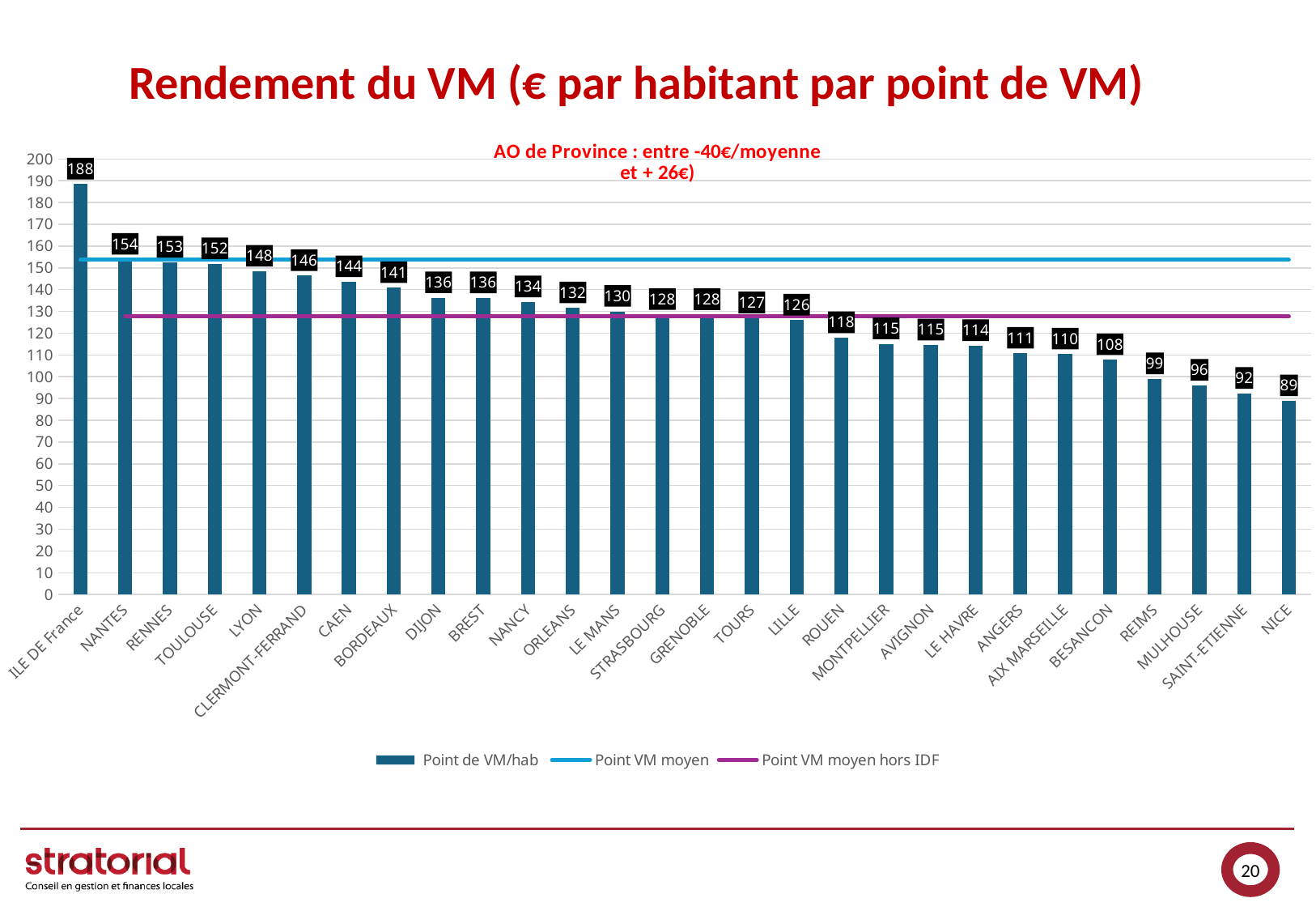
What is the value for NANTES? 154 What is the difference between the values for LYON and ROUEN? 30 What kind of chart is this? combination bar and line chart How many series does the legend list? 3 What is the difference between the values for ILE DE France and NICE? 99 What is the value for MONTPELLIER? 115 Which is larger, the value for CAEN or the value for LILLE? CAEN Do the bar values rise or fall from left to right along the x axis? fall What is the value for BORDEAUX? 141 Which category has the highest value? ILE DE France Which category has the lowest value? NICE How many categories are shown on the x axis? 28